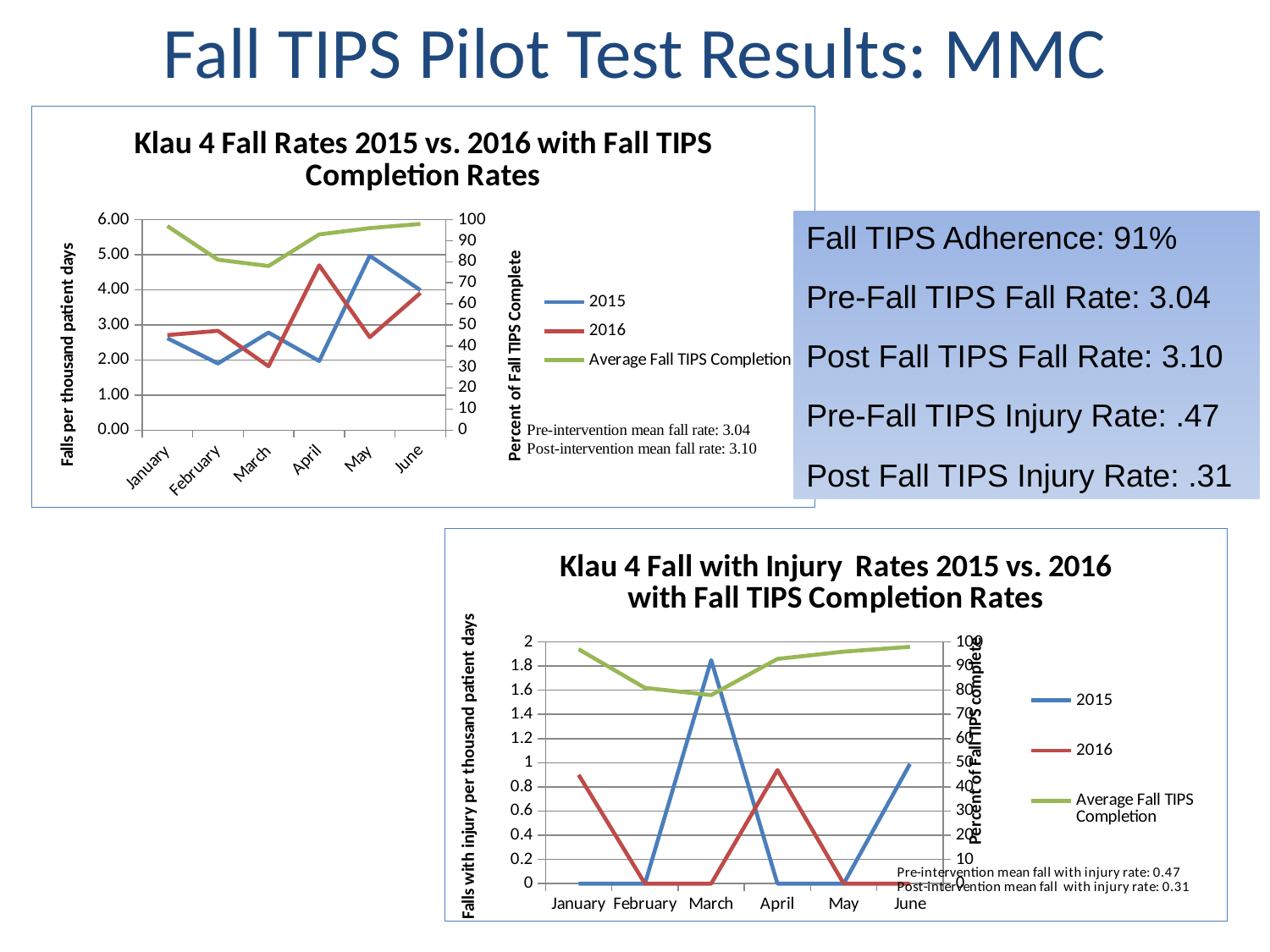
In the 'Klau 4 Fall with Injury Rates 2015 vs. 2016' chart, what colour is the line for the 2016 series? red How many months are plotted on the x axis of the 'Klau 4 Fall Rates 2015 vs. 2016' chart? 6 In the 'Klau 4 Fall with Injury Rates 2015 vs. 2016' chart, what is the 2016 value for February? 0 What kind of chart is the 'Klau 4 Fall Rates 2015 vs. 2016 with Fall TIPS Completion Rates' chart? line chart How many series does the legend list in the 'Klau 4 Fall Rates 2015 vs. 2016' chart? 3 In the 'Klau 4 Fall Rates 2015 vs. 2016' chart, is the 2015 value for May greater or less than 4.00? greater In the 'Klau 4 Fall with Injury Rates 2015 vs. 2016' chart, which month has the highest value for the 2015 series? March In the 'Klau 4 Fall Rates 2015 vs. 2016' chart, which is larger in April: the 2015 value or the 2016 value? 2016 In the 'Klau 4 Fall Rates 2015 vs. 2016' chart, which month has the highest value for the 2015 series? May In the 'Klau 4 Fall with Injury Rates 2015 vs. 2016' chart, is the 2015 value for March greater or less than 1.6? greater In the 'Klau 4 Fall Rates 2015 vs. 2016' chart, which month has the lowest value for the 2016 series? March In the 'Klau 4 Fall with Injury Rates 2015 vs. 2016' chart, what is the 2015 value for January? 0